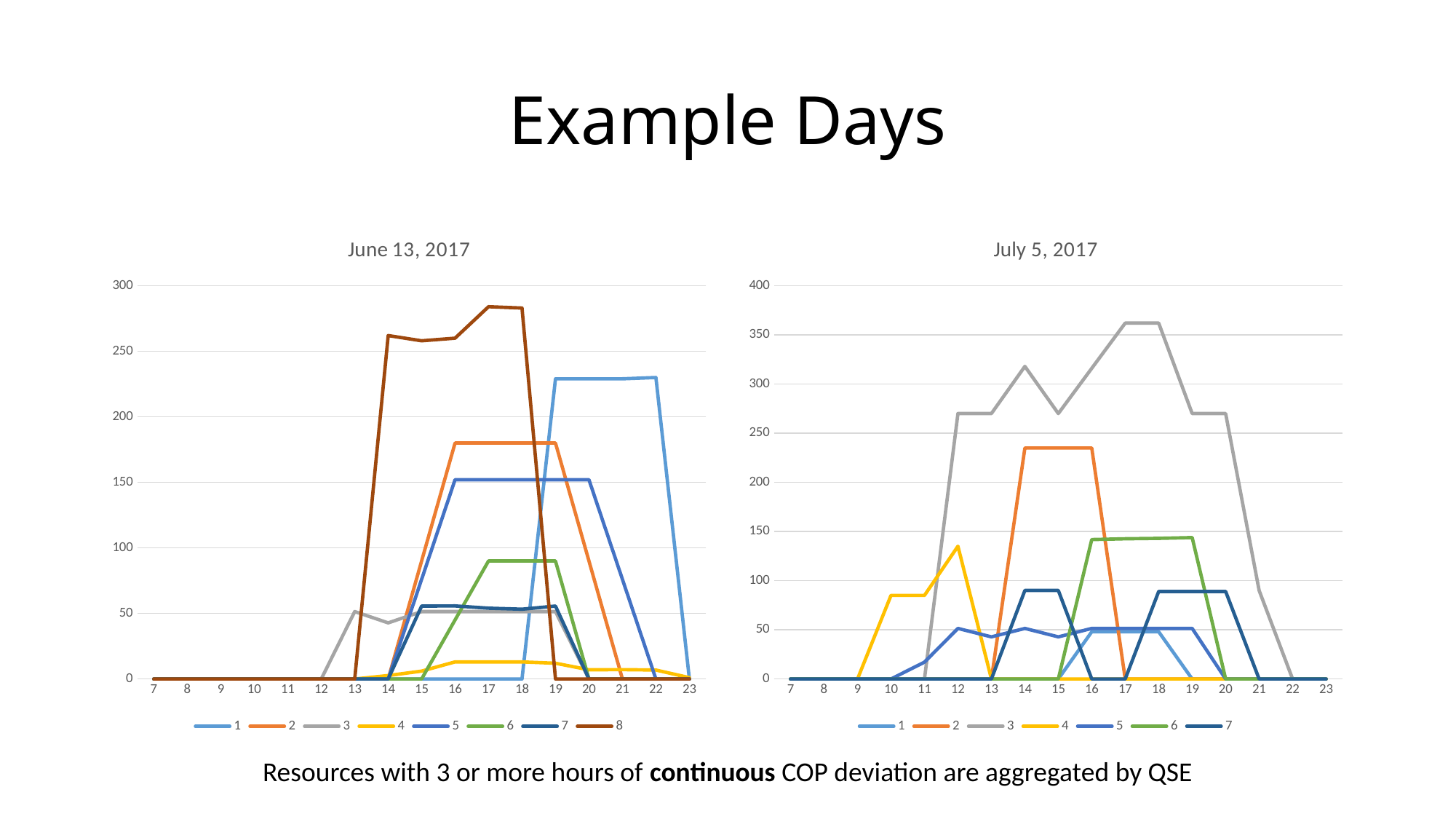
What is the maximum value shown on the y axis of the July 5, 2017 chart? 400 In the June 13, 2017 chart, is the value for series 6 at hour 17 greater or less than 100? less In the July 5, 2017 chart, which series reaches the highest value? 3 How many hour points are shown on the x axis of the July 5, 2017 chart? 17 In the July 5, 2017 chart, is the value for series 3 at hour 17 greater or less than 350? greater In the June 13, 2017 chart, is the value for series 8 at hour 17 greater or less than 250? greater In the June 13, 2017 chart, which series reaches the highest value? 8 How many series does the legend of the July 5, 2017 chart list? 7 How many series does the legend of the June 13, 2017 chart list? 8 What type of chart is the June 13, 2017 chart? line chart In the June 13, 2017 chart, at hour 16, which is larger: series 2 or series 5? series 2